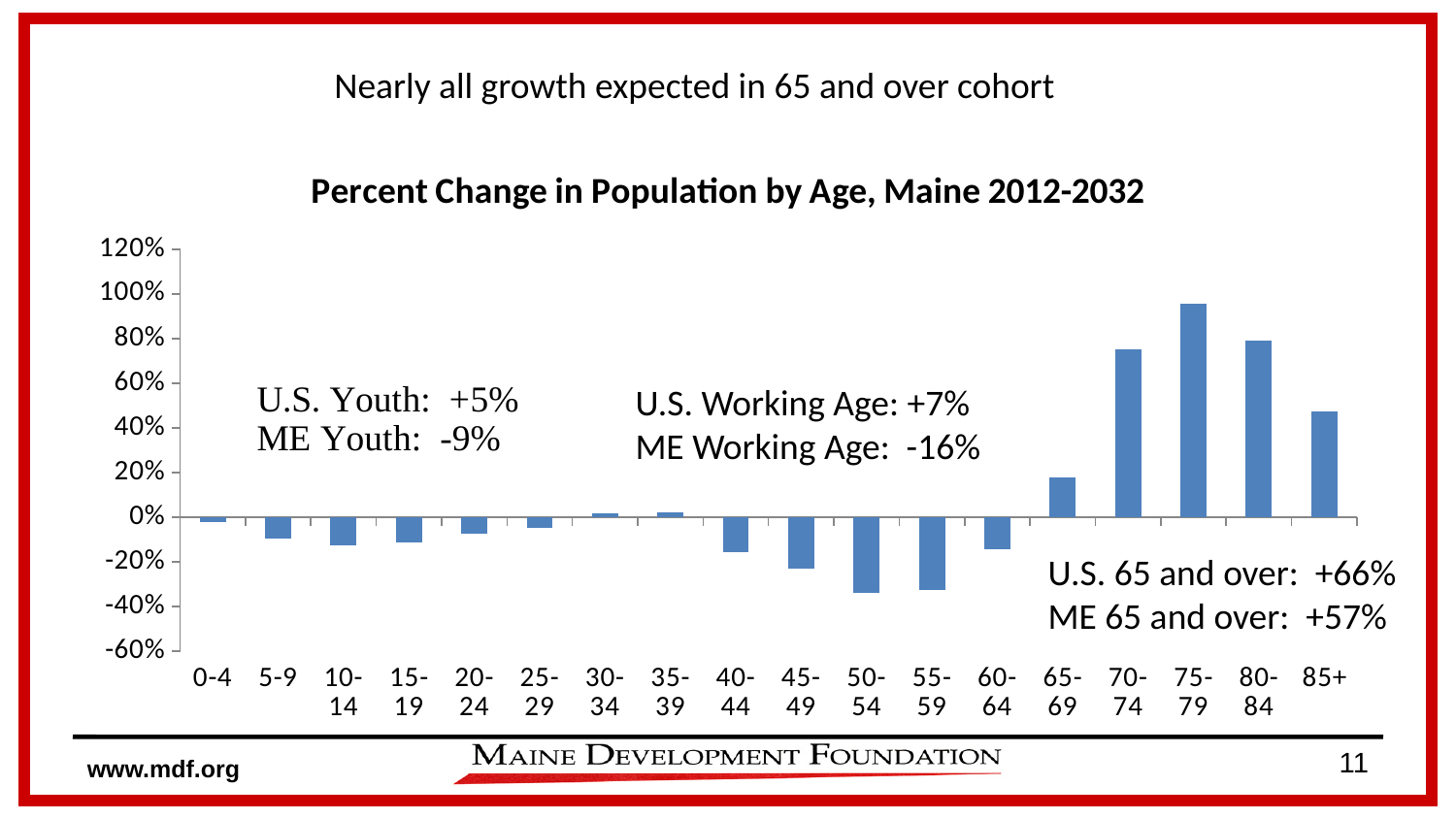
Is the value for the 85+ age group greater or less than 60%? less Is the value for the 75-79 age group greater or less than 80%? greater According to the text on the chart, what is the percent change for ME 65 and over? +57% Is the value for the 50-54 age group greater or less than -20%? less What is the title of the chart? Percent Change in Population by Age, Maine 2012-2032 Which age group has the highest percent change? 75-79 Do the values rise or fall from the 65-69 age group to the 75-79 age group? rise Which has the larger percent change, the 75-79 age group or the 80-84 age group? 75-79 What kind of chart is shown on the slide? bar chart How many age categories are shown on the x axis? 18